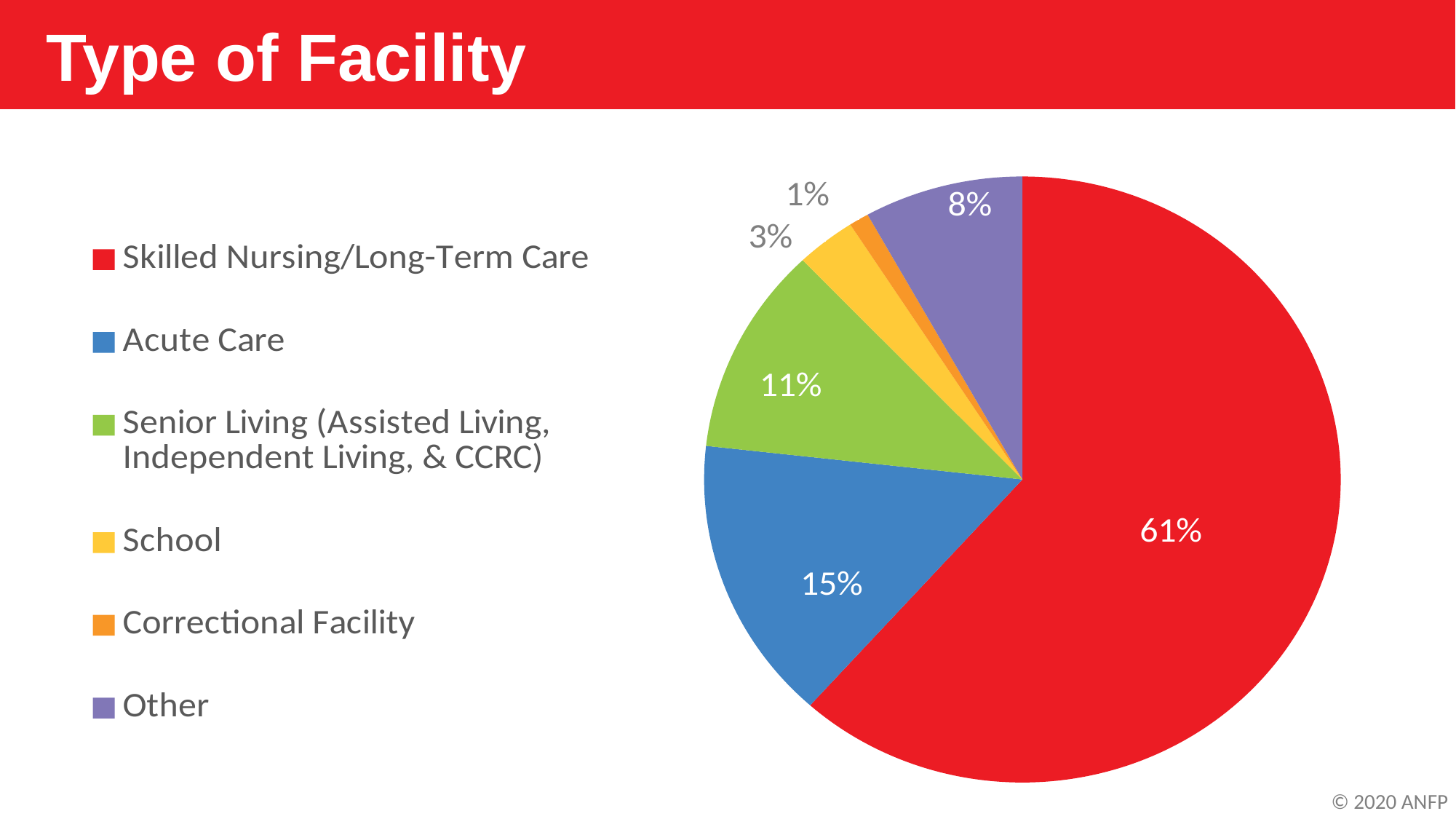
What share of the pie does Skilled Nursing/Long-Term Care represent? 61% What is the value for Correctional Facility? 1% What is the value for School? 3% Which facility type has the largest share? Skilled Nursing/Long-Term Care Which is larger, the share for Senior Living or the share for Other? Senior Living What is the value for Acute Care? 15% How many categories does the legend list? 6 What is the difference between the Acute Care and Other shares? 7% What is the value for Senior Living (Assisted Living, Independent Living, & CCRC)? 11% Which facility type has the smallest share? Correctional Facility What is the value for Other? 8% What kind of chart is shown on the slide? Pie chart